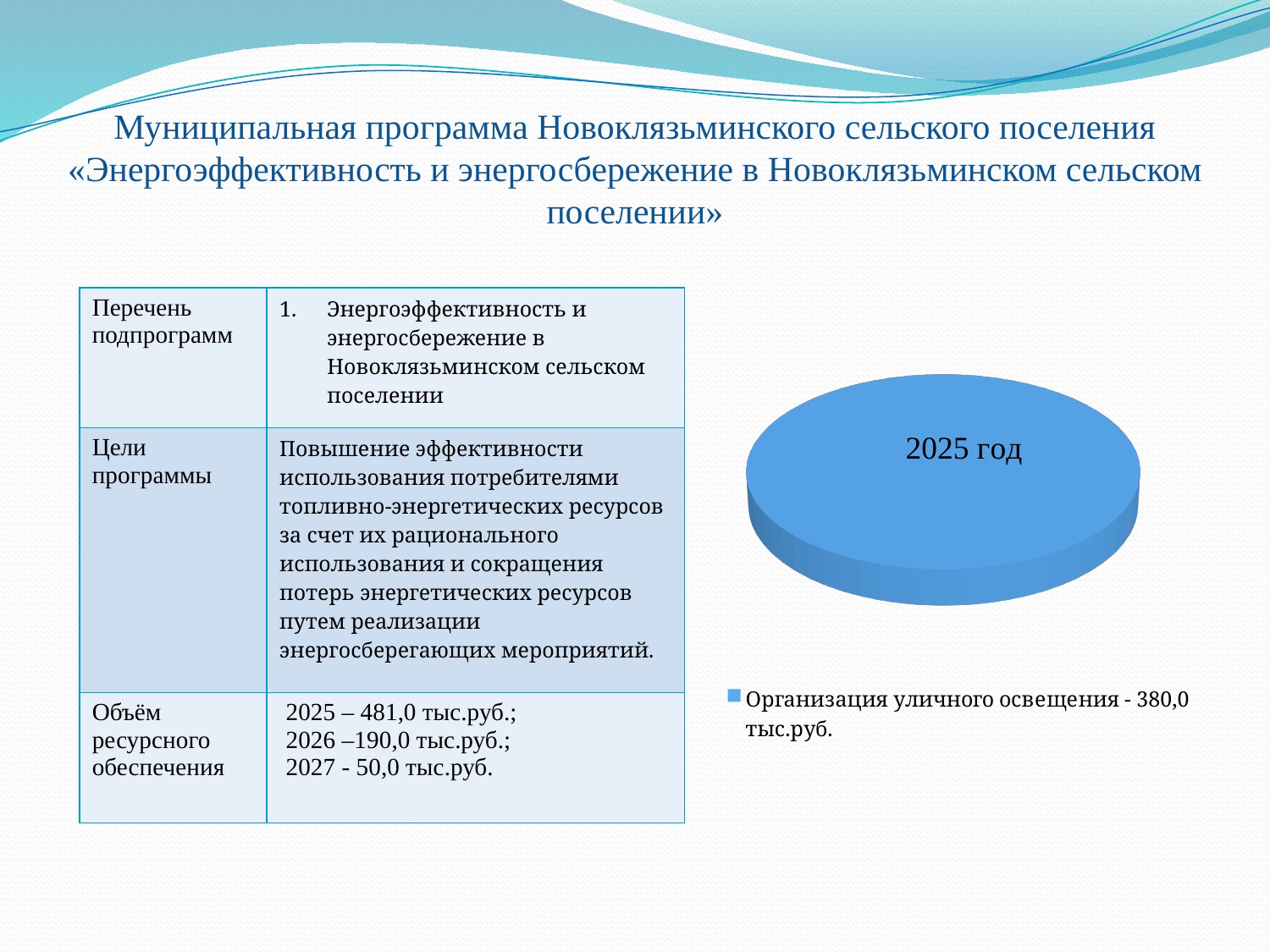
What kind of chart is shown on the slide? pie chart How many entries does the legend of the pie chart list? 1 What is the value shown in the legend for "Организация уличного освещения"? 380,0 тыс.руб. What is the title of the pie chart? 2025 год What share of the pie does the "Организация уличного освещения" slice take up? 100% How many slices does the pie chart have? 1 What category does the legend of the pie chart name? Организация уличного освещения - 380,0 тыс.руб.